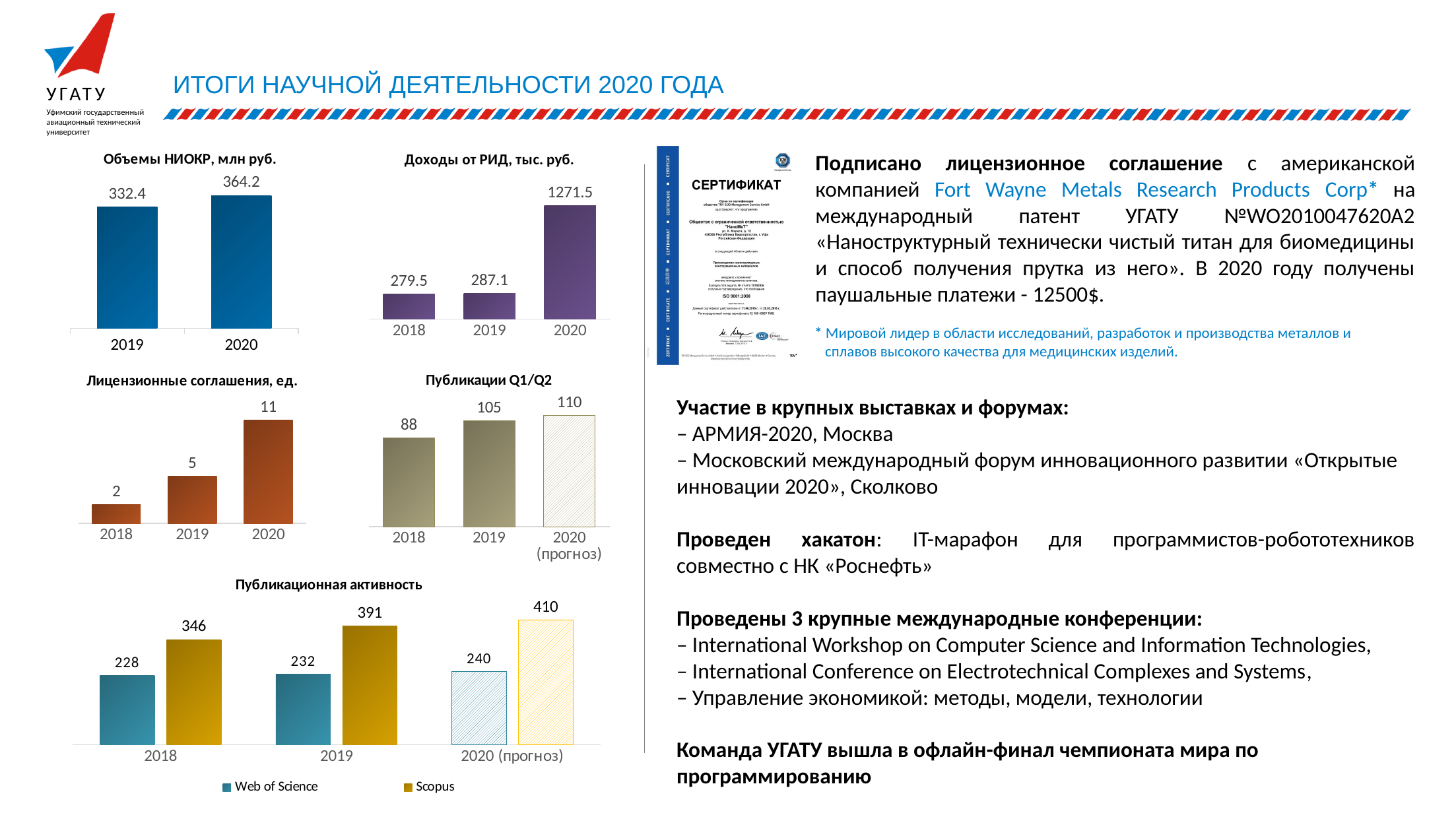
In the chart titled "Объемы НИОКР, млн руб.", by how much did the value increase from 2019 to 2020? 31.8 In the chart titled "Публикационная активность", how many series does the legend list? 2 In the chart titled "Лицензионные соглашения, ед.", which year has the lowest value? 2018 In the chart titled "Доходы от РИД, тыс. руб.", what is the value for 2019? 287.1 In the chart titled "Публикации Q1/Q2", what is the difference between the 2019 value and the 2018 value? 17 In the chart titled "Лицензионные соглашения, ед.", what is the value for 2020? 11 In the chart titled "Объемы НИОКР, млн руб.", what is the value for 2020? 364.2 In the chart titled "Лицензионные соглашения, ед.", do the values rise or fall from 2018 to 2020? rise In the chart titled "Публикационная активность", which series has the larger value for 2018, Web of Science or Scopus? Scopus In the chart titled "Публикации Q1/Q2", how many years are shown on the x axis? 3 In the chart titled "Доходы от РИД, тыс. руб.", which year has the highest value? 2020 In the chart titled "Публикационная активность", what is the Scopus value for 2019? 391